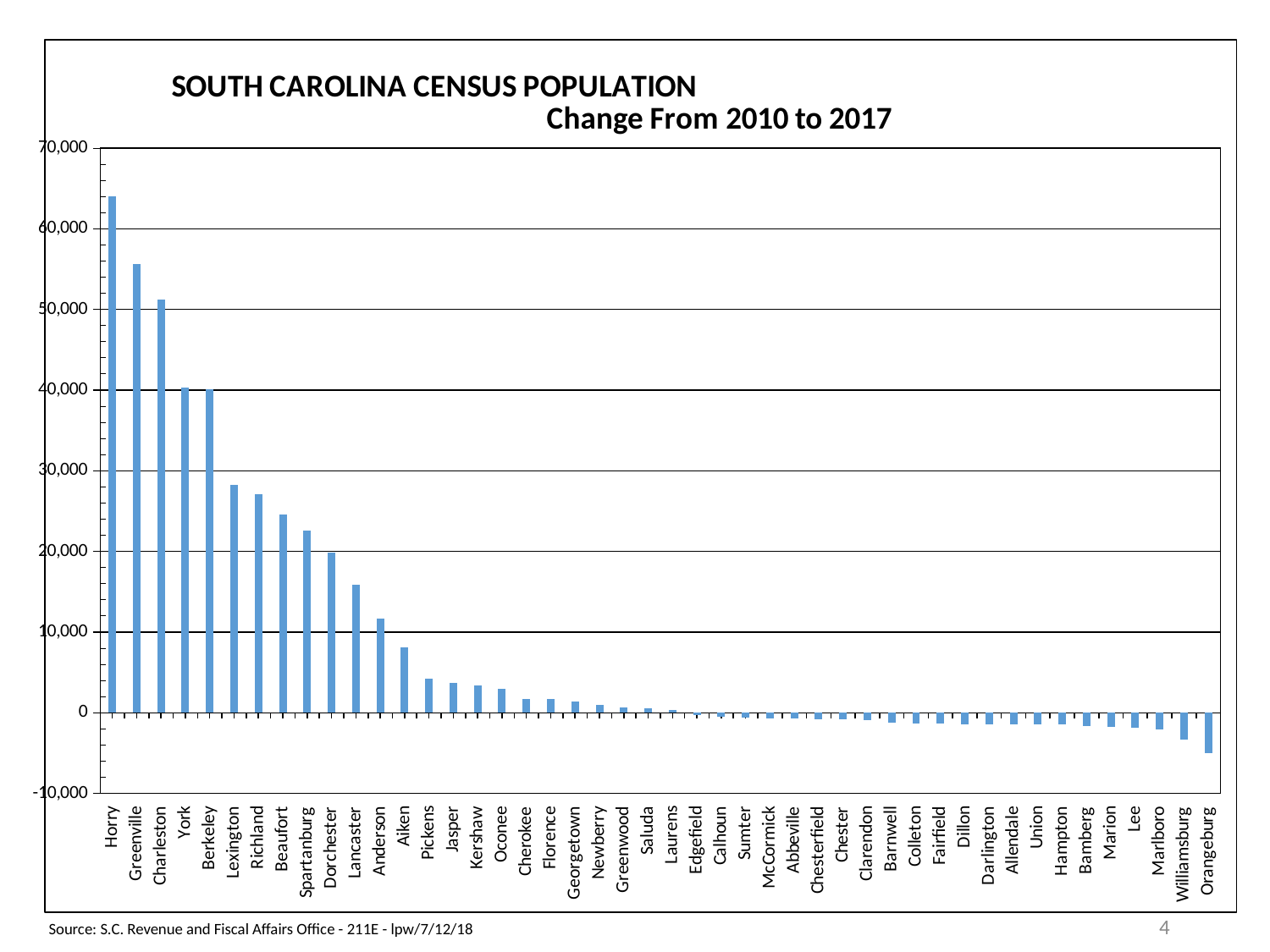
Do the values generally rise or fall moving from left to right along the x axis? fall Is the value for Lexington greater or less than 30,000? less Is the value for Charleston greater or less than 50,000? greater Is the value for Greenville greater or less than 60,000? less Which county has the lowest (most negative) population change from 2010 to 2017? Orangeburg Which county has the largest population change from 2010 to 2017? Horry What kind of chart is shown on the slide? bar chart Which county has the larger population change, Greenville or Charleston? Greenville How many counties are shown on the x axis of the chart? 46 What is the title of the chart? SOUTH CAROLINA CENSUS POPULATION Change From 2010 to 2017